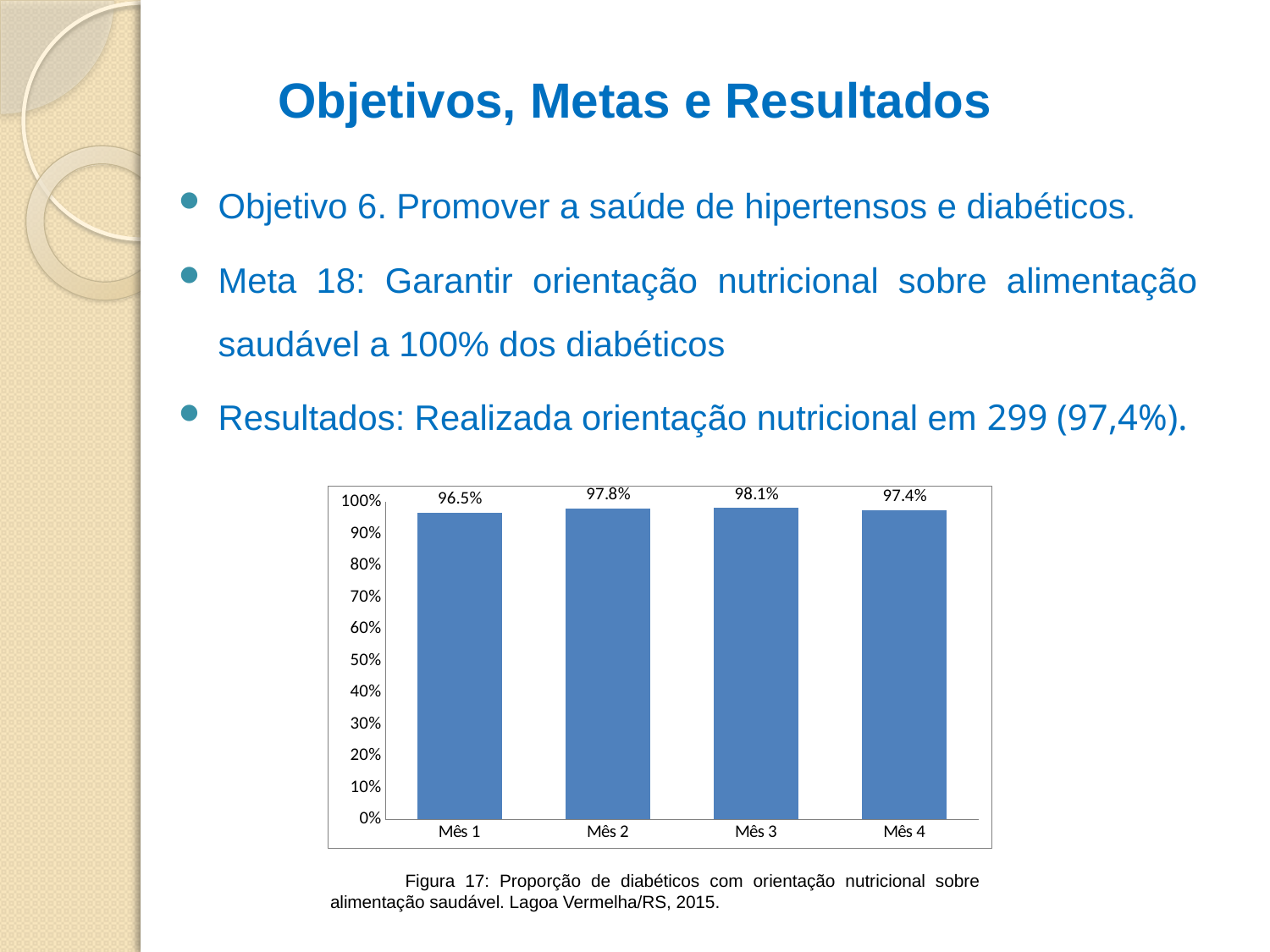
What is the value for Mês 3? 98.1% What kind of chart is shown on the slide? bar chart Which is larger, the value for Mês 2 or the value for Mês 4? Mês 2 What is the value for Mês 4? 97.4% Which month has the lowest value? Mês 1 Do the values rise or fall from Mês 1 to Mês 3? rise What is the value for Mês 2? 97.8% How many months are shown on the x axis? 4 Is the value for Mês 1 greater or less than 90%? greater What is the value for Mês 1? 96.5% What is the difference between the values for Mês 3 and Mês 1? 1.6% Which month has the highest value? Mês 3